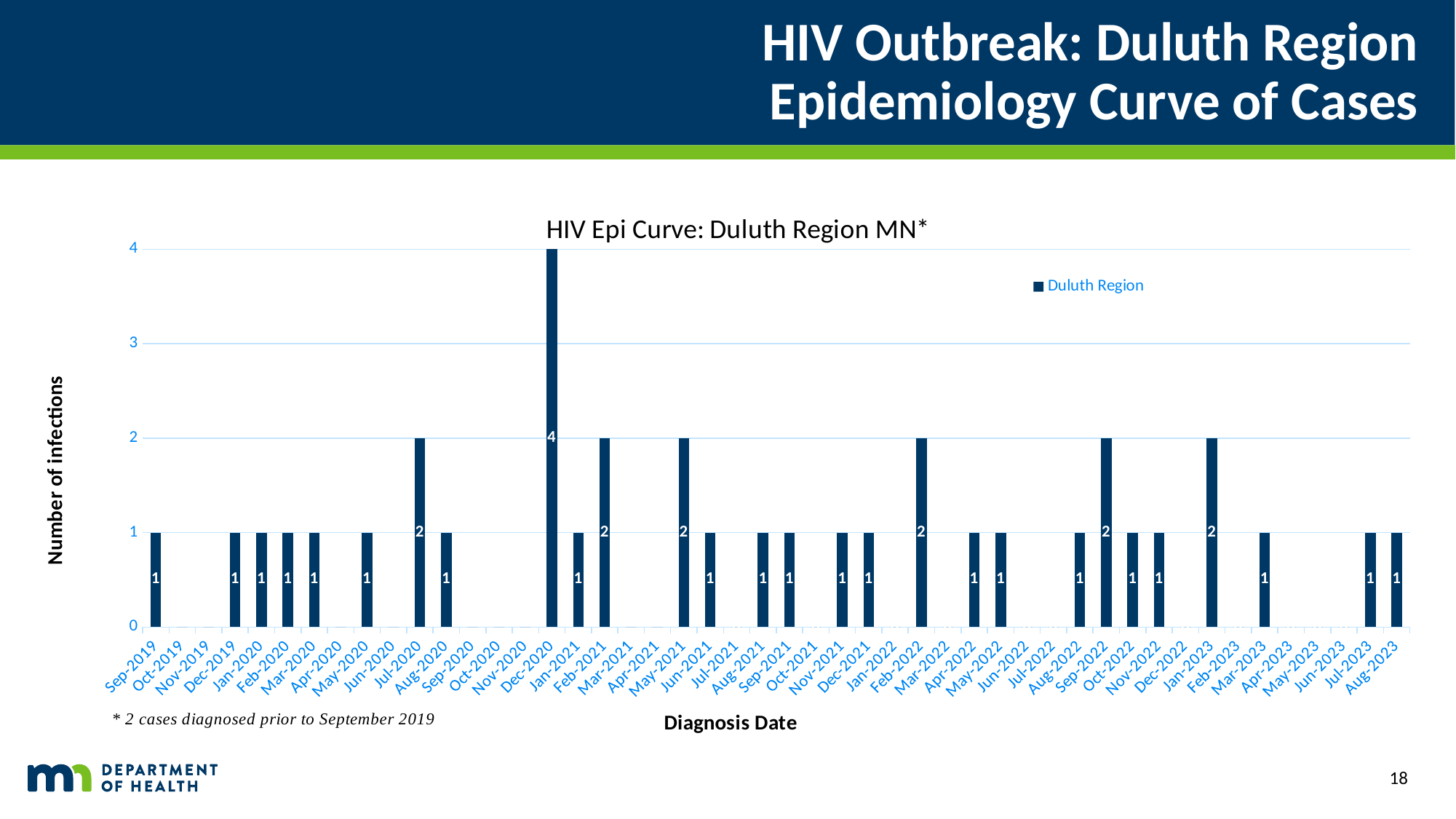
Is the value for Dec-2020 greater or less than 3? greater What is the label on the y axis of the chart? Number of infections How many infections are shown for Sep-2022? 2 How many months have a bar showing exactly 2 infections? 6 Which month has more infections, Jul-2020 or Aug-2020? Jul-2020 What is the difference between the number of infections in Dec-2020 and Feb-2021? 2 Which diagnosis month has the highest number of infections? Dec-2020 What is the title of the chart? HIV Epi Curve: Duluth Region MN* What kind of chart is shown on the slide? Bar chart How many infections are shown for Dec-2020? 4 How many infections are shown for Jul-2020? 2 How many series does the legend list? 1